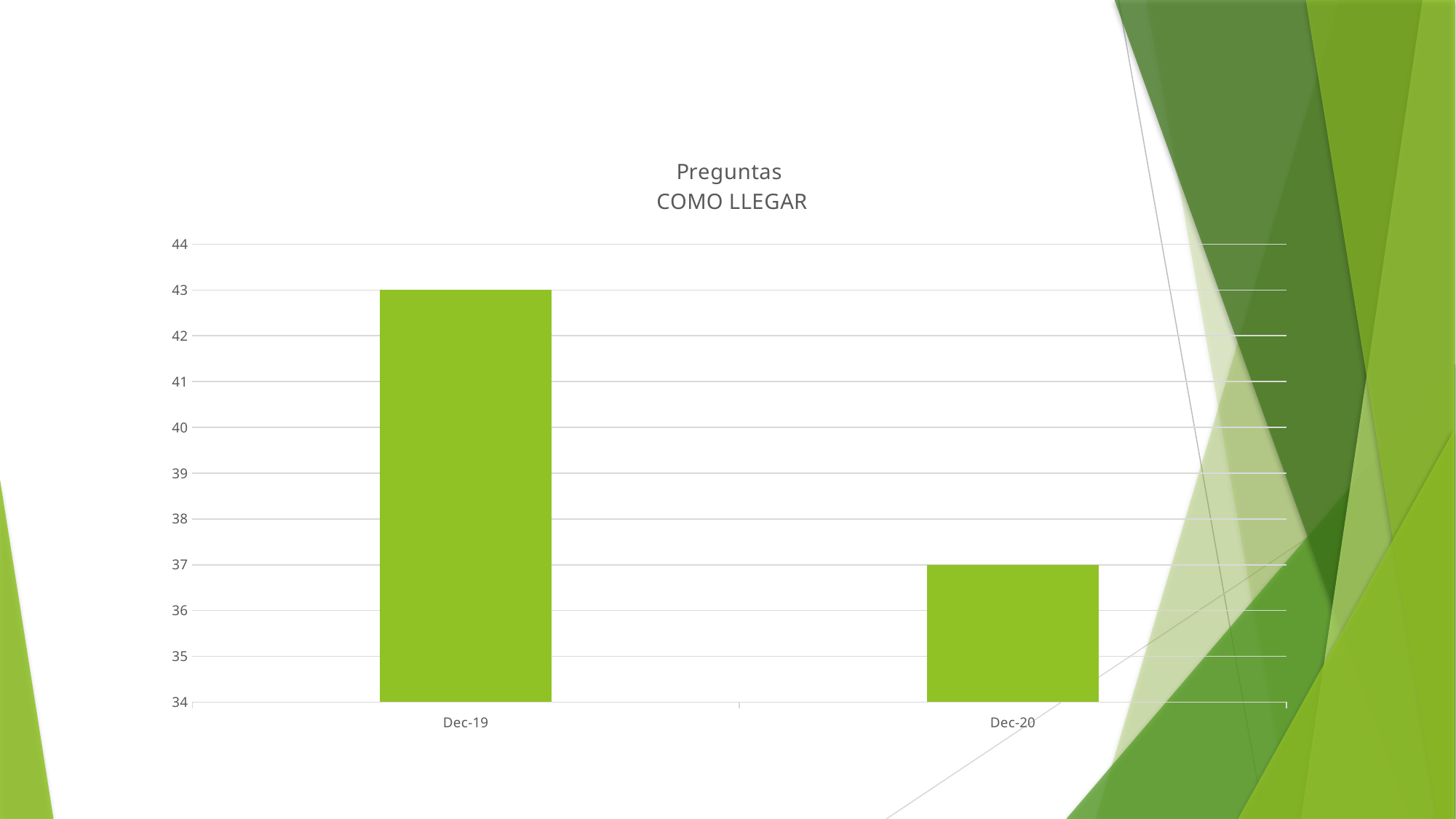
What is the difference between the values for Dec-19 and Dec-20? 6 Is the value for Dec-20 greater or less than 40? less What is the value for Dec-19? 43 Which category has the lowest value? Dec-20 Which category has the highest value? Dec-19 Do the values rise or fall from Dec-19 to Dec-20? fall What is the lowest value shown on the vertical axis? 34 What kind of chart is shown on the slide? bar chart What is the value for Dec-20? 37 Which is larger, the value for Dec-19 or the value for Dec-20? Dec-19 How many bars does the chart show? 2 What is the title of the chart? Preguntas COMO LLEGAR